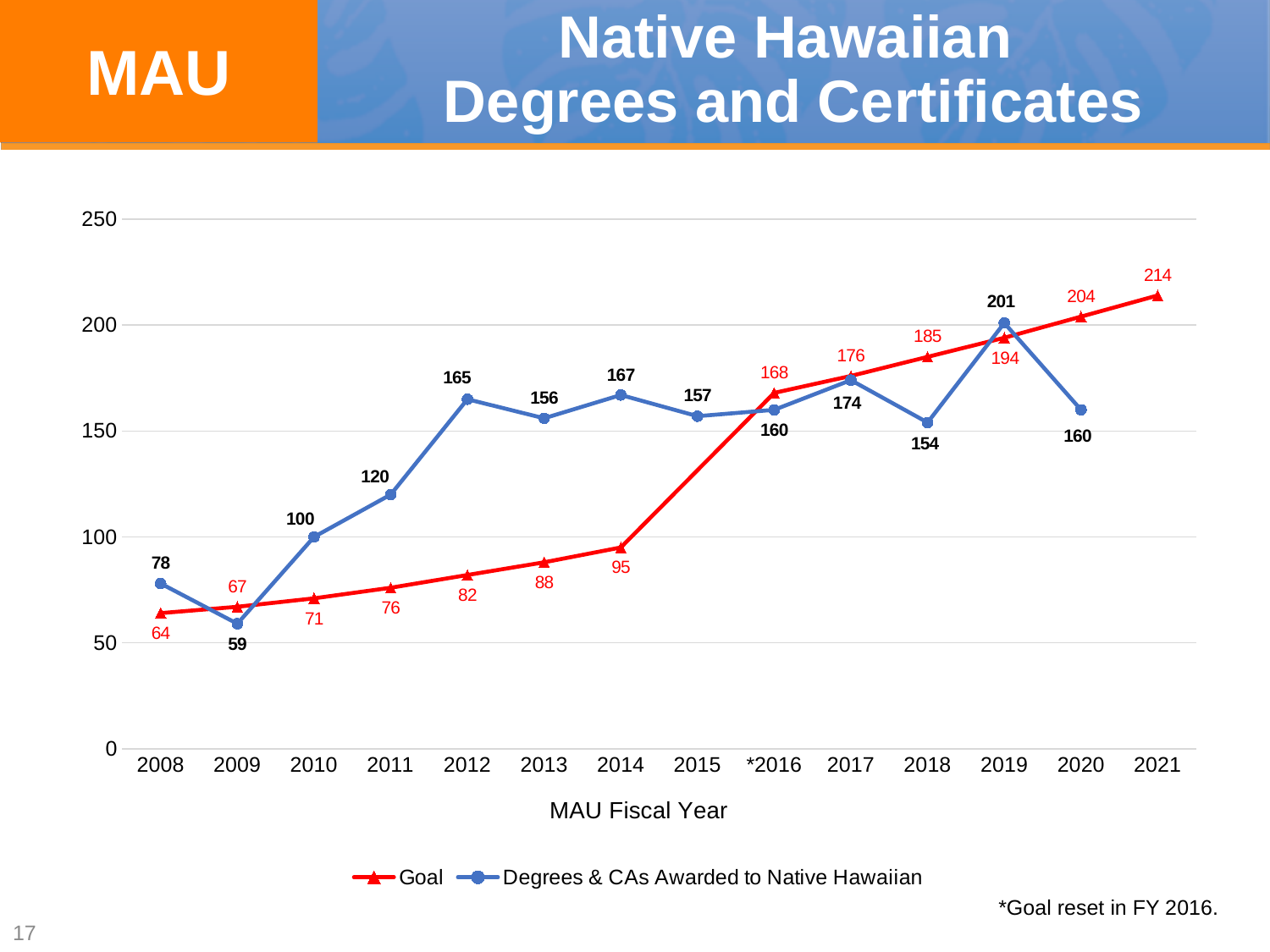
In which fiscal year was the number of Degrees & CAs Awarded to Native Hawaiian highest? 2019 How many fiscal years are shown on the x axis? 14 What is the Goal value for 2021? 214 What is the title of the x axis? MAU Fiscal Year Does the Goal series rise or fall from 2008 to 2021? rise In which fiscal year was the number of Degrees & CAs Awarded to Native Hawaiian lowest? 2009 In 2012, which series has the larger value, Goal or Degrees & CAs Awarded to Native Hawaiian? Degrees & CAs Awarded to Native Hawaiian How many Degrees & CAs were awarded to Native Hawaiians in 2019? 201 How many series does the legend list? 2 Is the value for Degrees & CAs Awarded to Native Hawaiian in 2011 greater or less than 100? greater In 2020, how much higher is the Goal than the Degrees & CAs Awarded to Native Hawaiian? 44 What kind of chart is shown on the slide? line chart